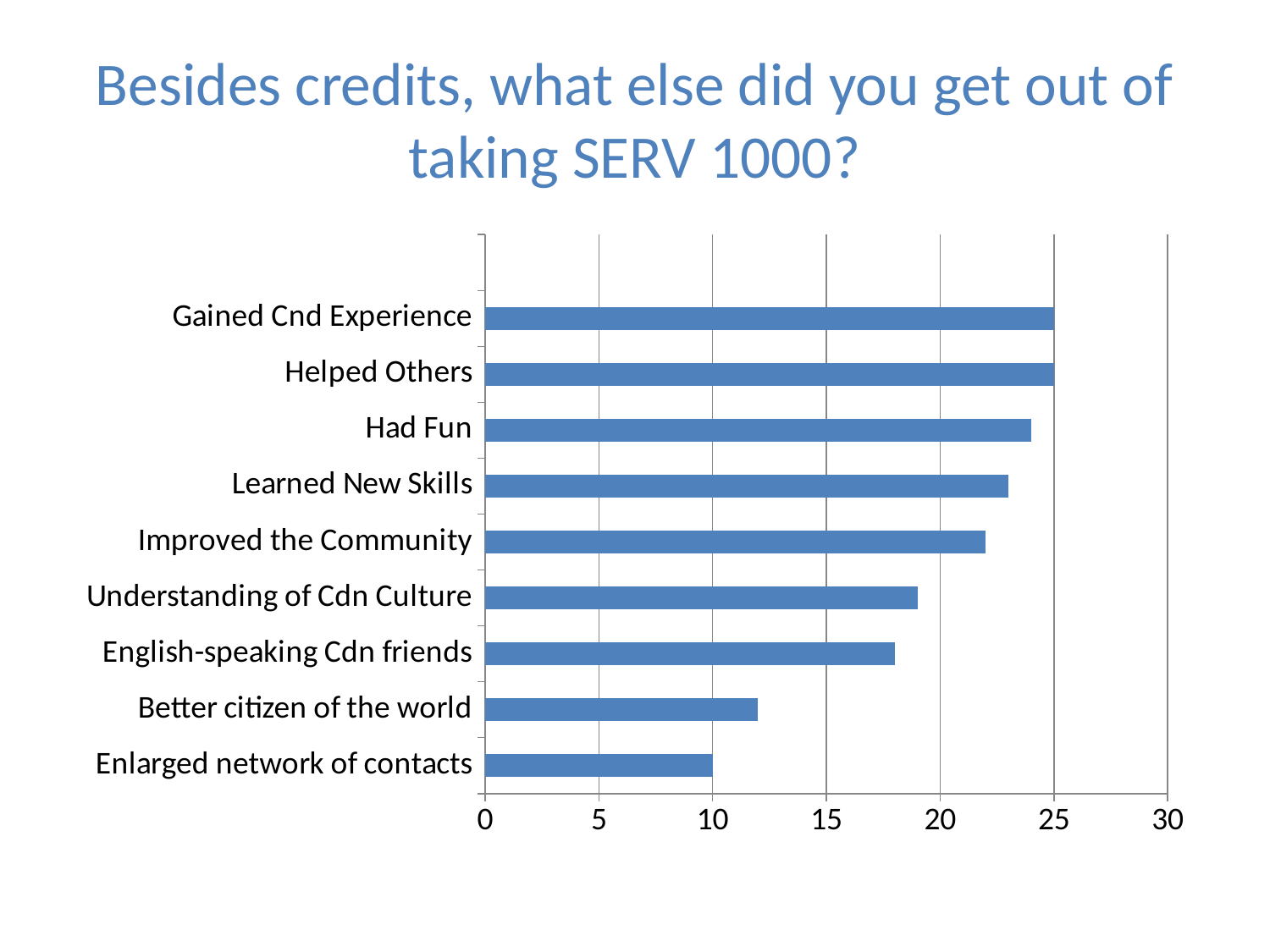
Is the value for Understanding of Cdn Culture greater or less than 20? less What is the value for Enlarged network of contacts? 10 How many categories are plotted in the chart? 9 Which category has the lowest value? Enlarged network of contacts Which is larger, the value for Learned New Skills or the value for Understanding of Cdn Culture? Learned New Skills Is the value for Better citizen of the world greater or less than 15? less Is the value for Had Fun greater or less than 20? greater What is the difference between the value for Gained Cnd Experience and the value for Enlarged network of contacts? 15 What is the title of the chart on the slide? Besides credits, what else did you get out of taking SERV 1000? What is the value for Gained Cnd Experience? 25 What kind of chart is shown on the slide? bar chart